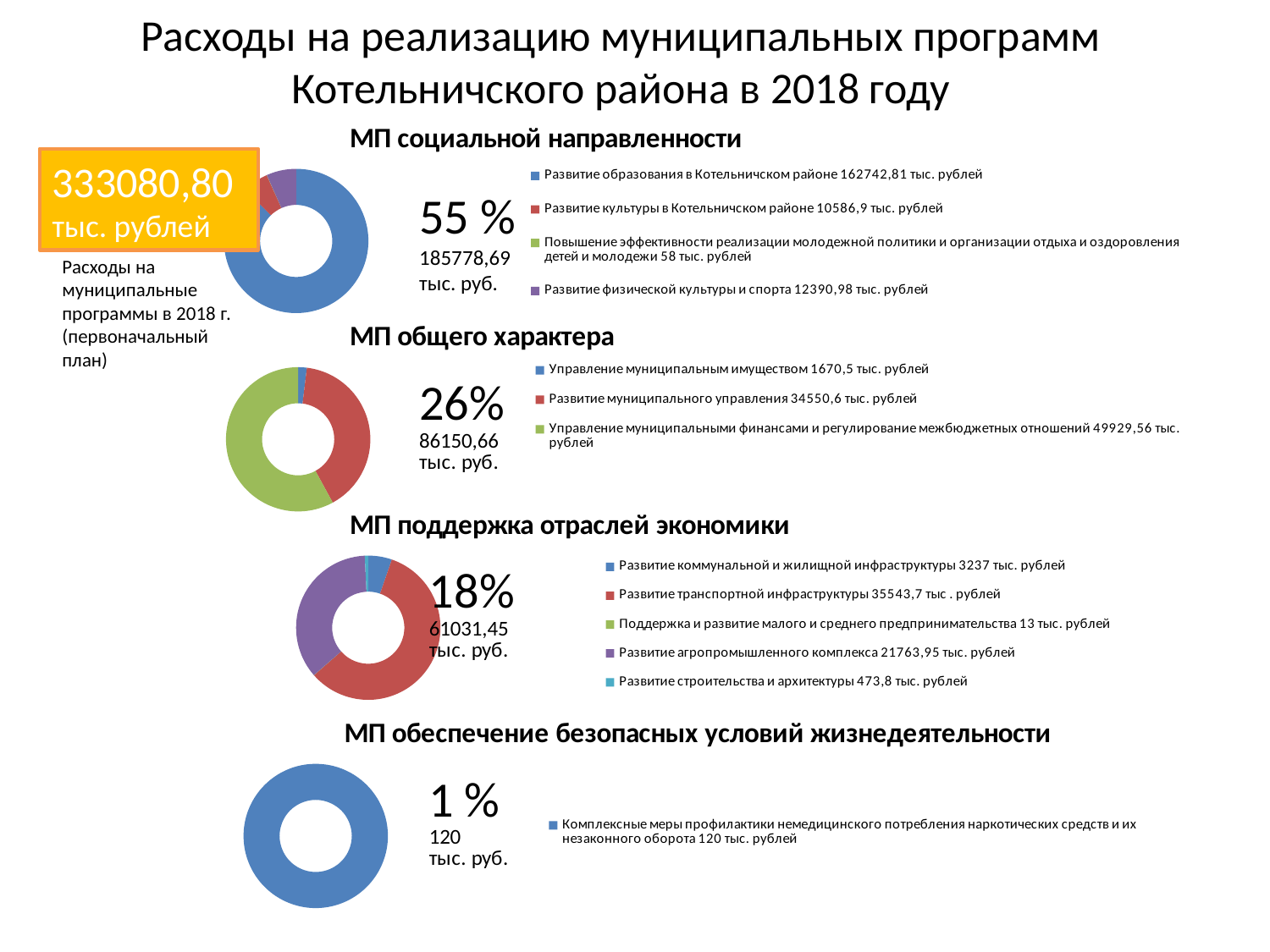
In the "МП социальной направленности" chart, which category has the lowest value? Повышение эффективности реализации молодежной политики и организации отдыха и оздоровления детей и молодежи In the "МП социальной направленности" chart, how many categories does the legend list? 4 In the "МП общего характера" chart, which category has the highest value? Управление муниципальными финансами и регулирование межбюджетных отношений In the "МП поддержка отраслей экономики" chart, which is larger: "Развитие транспортной инфраструктуры" or "Развитие агропромышленного комплекса"? Развитие транспортной инфраструктуры In the "МП поддержка отраслей экономики" chart, how many categories does the legend list? 5 In the "МП общего характера" chart, what is the difference between "Управление муниципальными финансами и регулирование межбюджетных отношений" and "Развитие муниципального управления"? 15378,96 тыс. рублей In the "МП социальной направленности" chart, what is the value for "Развитие образования в Котельничском районе"? 162742,81 тыс. рублей In the "МП социальной направленности" chart, what is the difference between "Развитие физической культуры и спорта" and "Развитие культуры в Котельничском районе"? 1804,08 тыс. рублей In the "МП общего характера" chart, what is the value for "Развитие муниципального управления"? 34550,6 тыс. рублей What share of total expenditure do the "МП общего характера" programmes account for, according to the slide? 26% In the "МП поддержка отраслей экономики" chart, what is the value for "Развитие строительства и архитектуры"? 473,8 тыс. рублей What kind of chart is used for "МП социальной направленности"? Doughnut chart